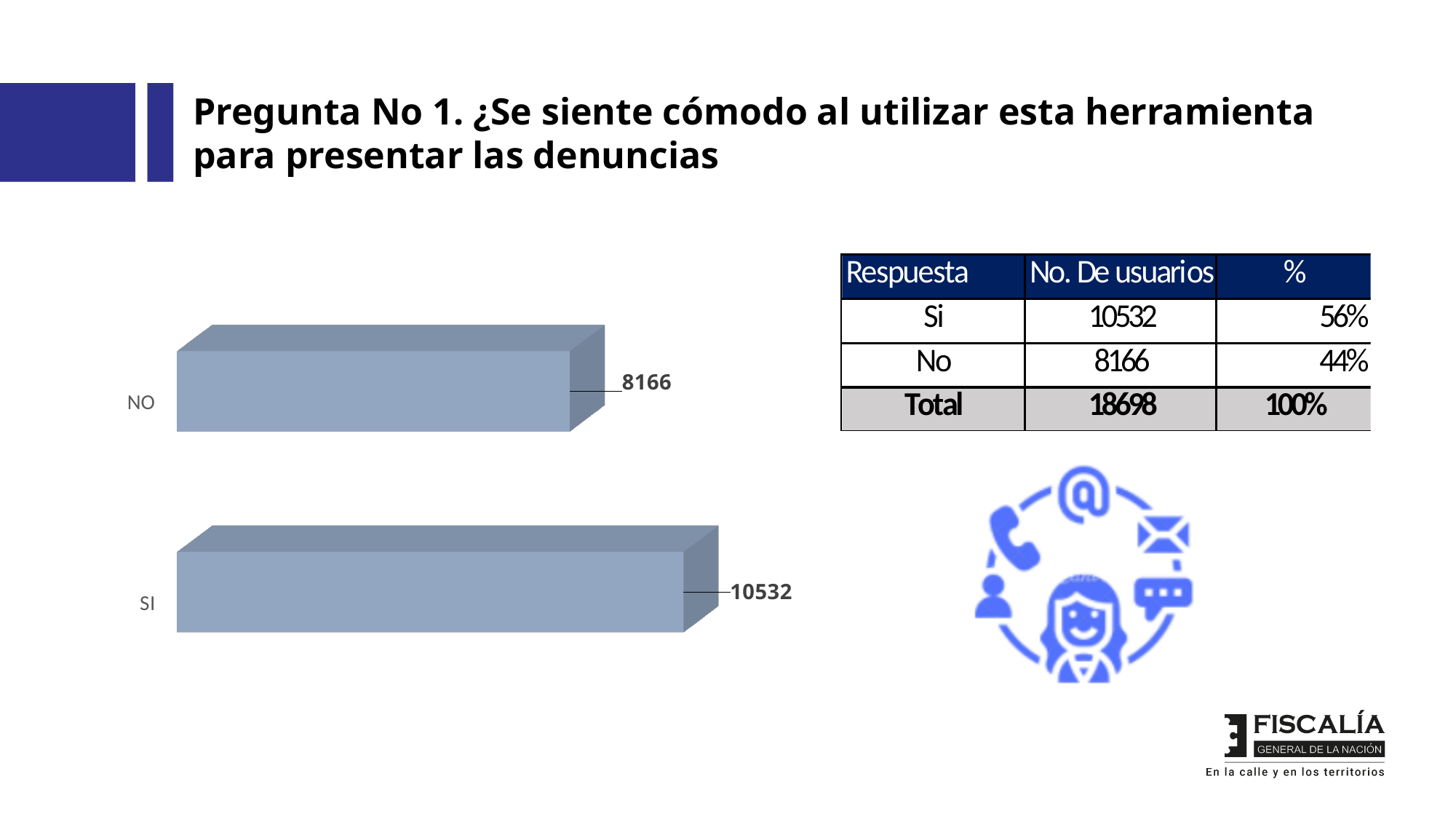
How many categories are shown in the bar chart? 2 What is the difference between the SI and NO values in the bar chart? 2366 Which category has the lowest value in the bar chart? NO What is the value for NO in the bar chart? 8166 What colour are the bars in the chart? blue-grey Which category has the highest value in the bar chart? SI What is the value for SI in the bar chart? 10532 Are the bars in the chart horizontal or vertical? horizontal Which is larger in the bar chart, SI or NO? SI What kind of chart is shown on the slide? bar chart What is the total of the SI and NO values in the bar chart? 18698